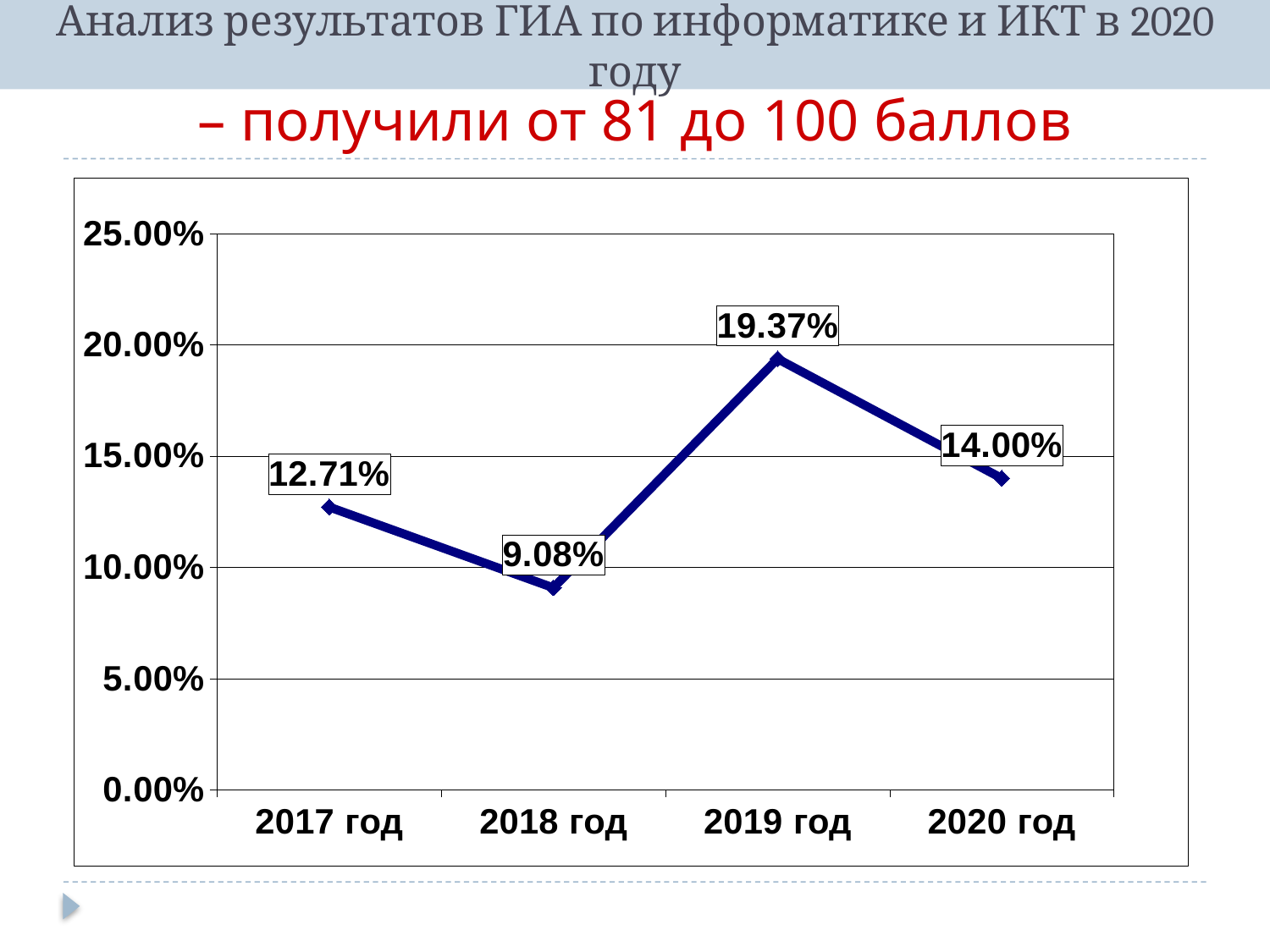
What kind of chart is shown on the slide? line chart What is the value for 2019 год? 19.37% What is the value for 2017 год? 12.71% Which year has the lowest value? 2018 год Is the value for 2019 год greater or less than 15.00%? greater How many years are plotted on the chart? 4 Which year has the highest value? 2019 год Does the value rise or fall from 2019 год to 2020 год? fall What is the value for 2018 год? 9.08% What is the difference between the values for 2019 год and 2018 год? 10.29% What is the value for 2020 год? 14.00% Which is larger, the value for 2017 год or the value for 2020 год? 2020 год